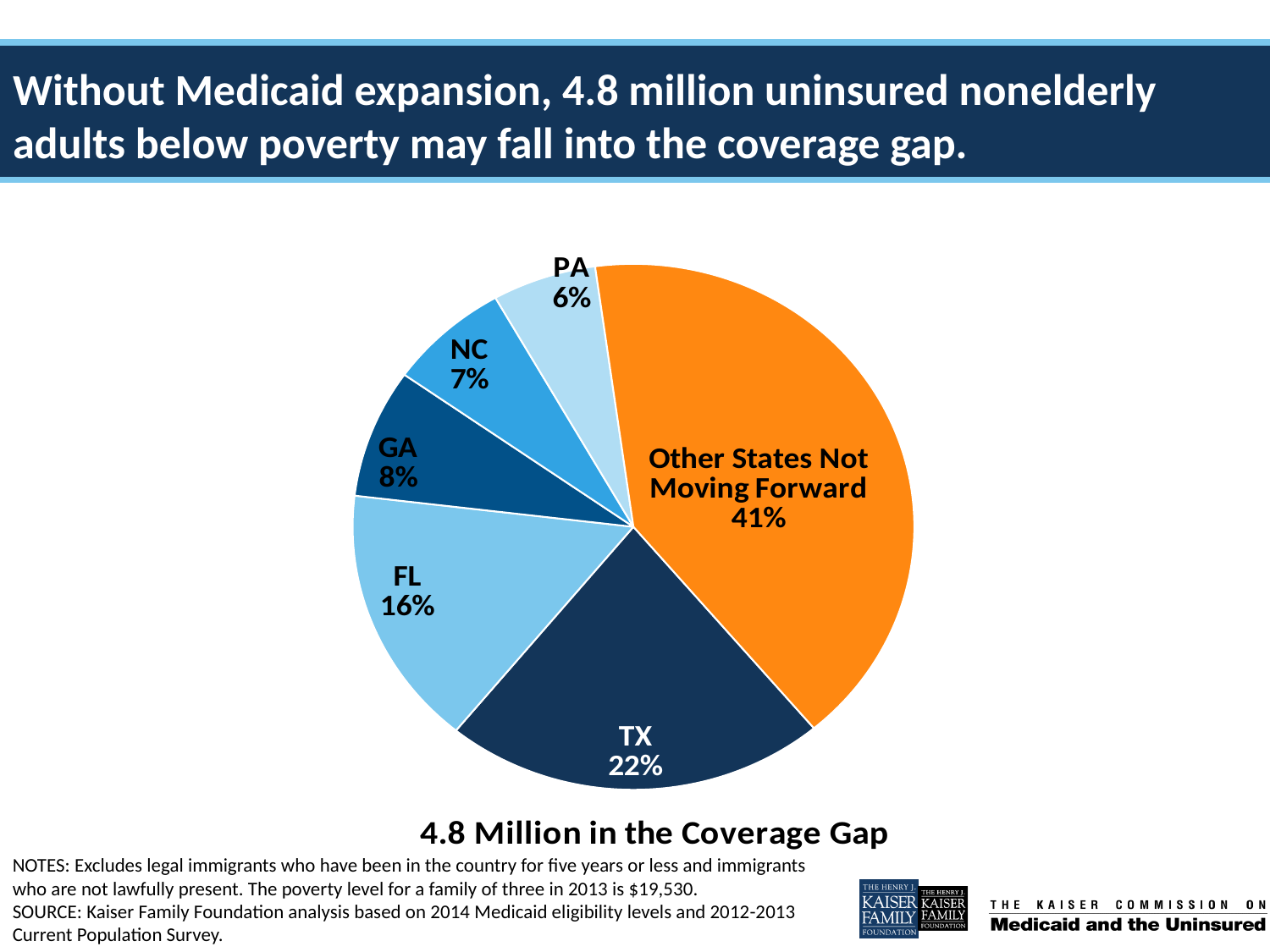
What is the combined share of TX and FL? 38% What is the label shown beneath the pie chart? 4.8 Million in the Coverage Gap Which slice of the pie is the smallest? PA What share of the coverage gap does TX account for? 22% Which is larger, the share for NC or the share for GA? GA What share of the coverage gap does PA account for? 6% What share of the coverage gap does GA account for? 8% What is the difference in percentage points between TX and FL? 6 How many slices does the pie chart have? 6 What kind of chart is shown on the slide? Pie chart Which slice of the pie is the largest? Other States Not Moving Forward What share of the coverage gap does FL account for? 16%